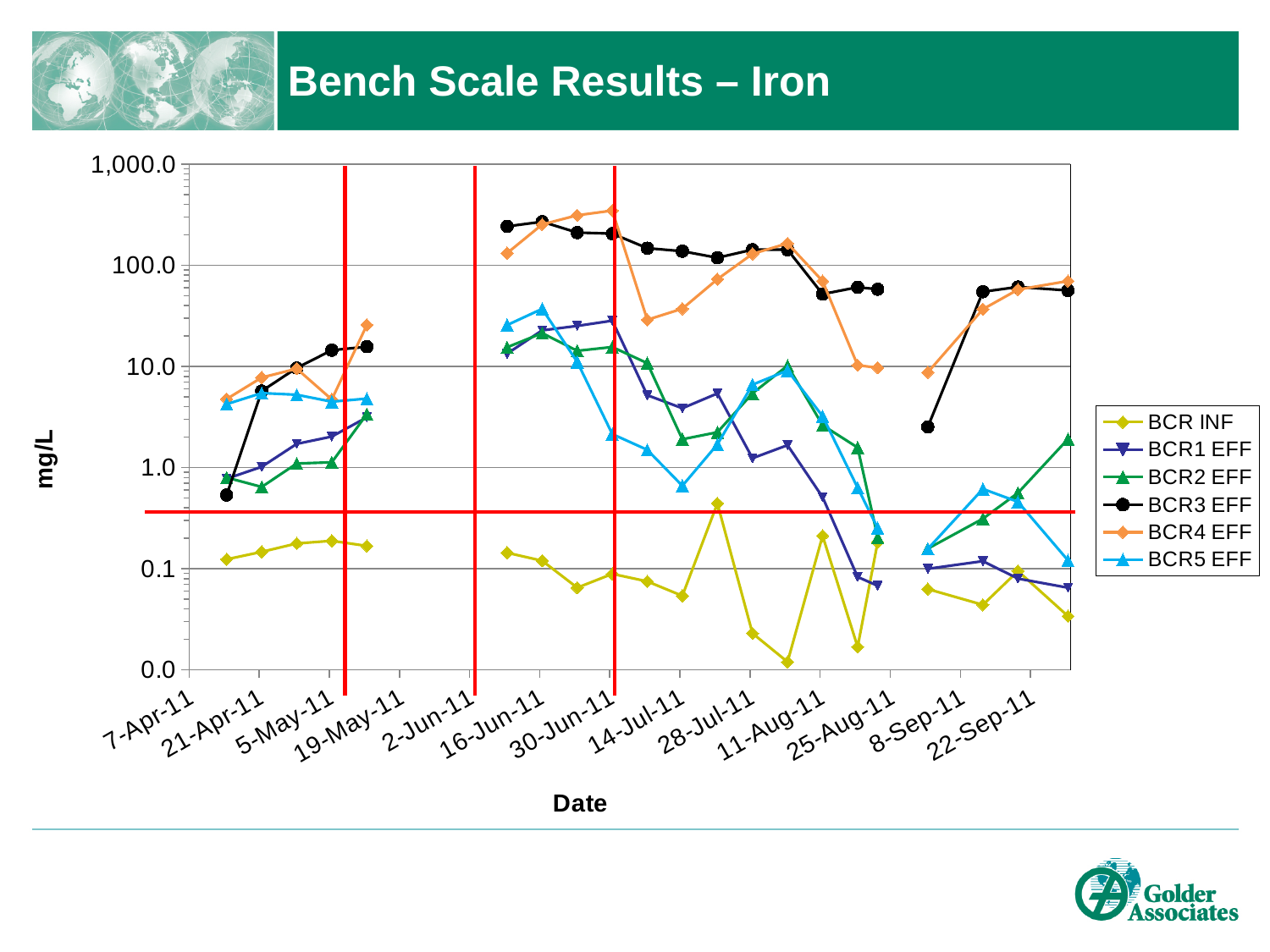
Is the highest value of BCR5 EFF greater or less than 100.0? less Is the highest value of BCR INF greater or less than 1.0? less What is the title of the chart? Bench Scale Results – Iron What type of chart is shown on the slide? line chart Does the BCR3 EFF series rise or fall between 16-Jun-11 and 25-Aug-11? fall Is the highest value of BCR3 EFF greater or less than 100.0? greater Around 30-Jun-11, which series has the higher value, BCR4 EFF or BCR5 EFF? BCR4 EFF Around 16-Jun-11, which series has the higher value, BCR3 EFF or BCR INF? BCR3 EFF How many series does the legend list? 6 Does the BCR3 EFF series rise or fall between 21-Apr-11 and 19-May-11? rise What is the label on the y axis of the chart? mg/L